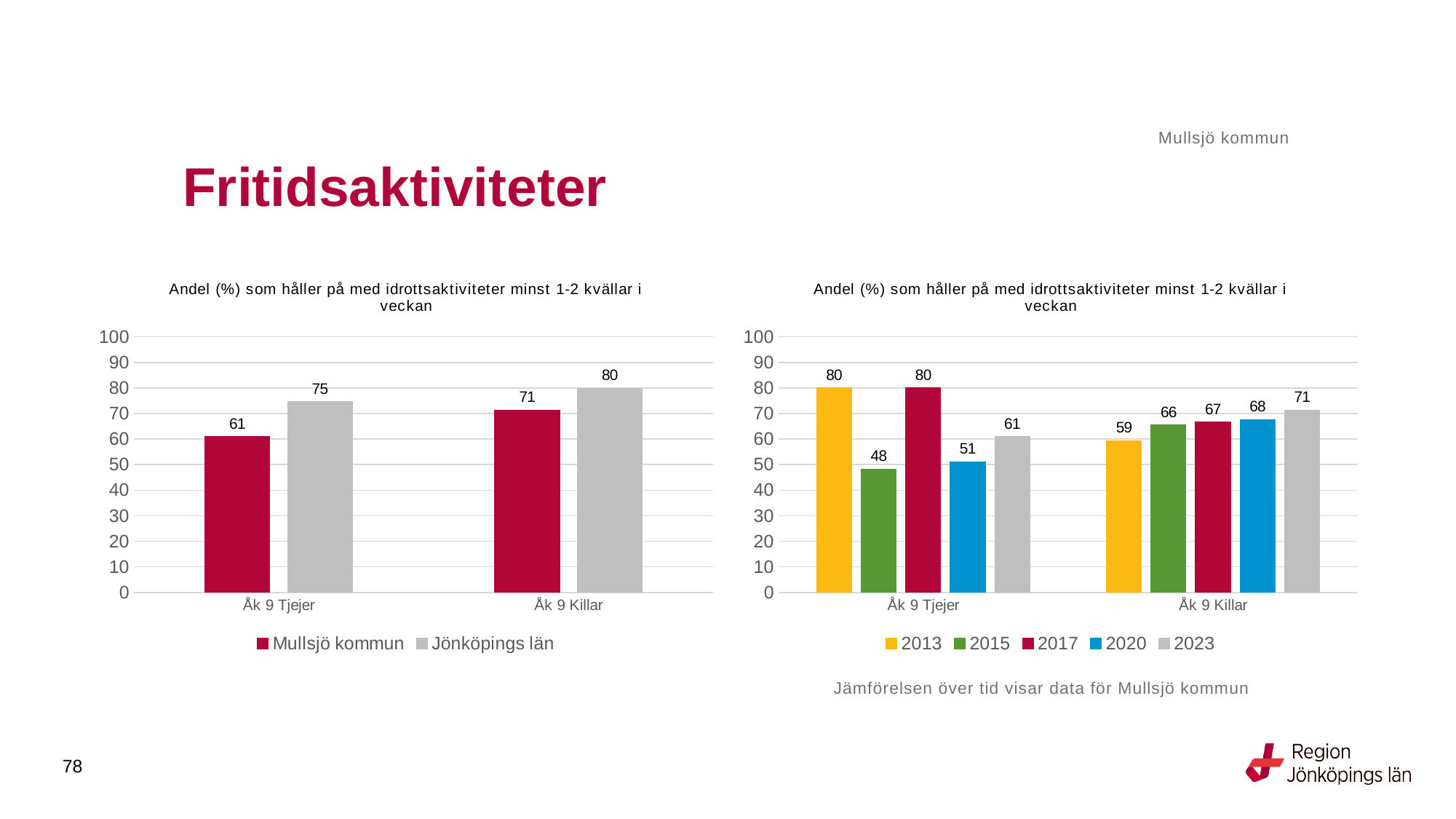
What kind of chart is the right chart? Bar chart In the right chart, what is the value for 2020 for Åk 9 Killar? 68 In the right chart, how many series does the legend list? 5 In the right chart, which year has the lowest value for Åk 9 Tjejer? 2015 In the left chart, what is the value for Jönköpings län for Åk 9 Killar? 80 In the right chart, what is the value for 2015 for Åk 9 Tjejer? 48 In the right chart, what is the difference between the 2023 values for Åk 9 Killar and Åk 9 Tjejer? 10 In the left chart, what is the difference between Jönköpings län and Mullsjö kommun for Åk 9 Tjejer? 14 In the left chart, how many series does the legend list? 2 In the left chart, what is the value for Mullsjö kommun for Åk 9 Tjejer? 61 In the right chart, which year has the lowest value for Åk 9 Killar? 2013 In the left chart, which is larger for Åk 9 Killar: Mullsjö kommun or Jönköpings län? Jönköpings län